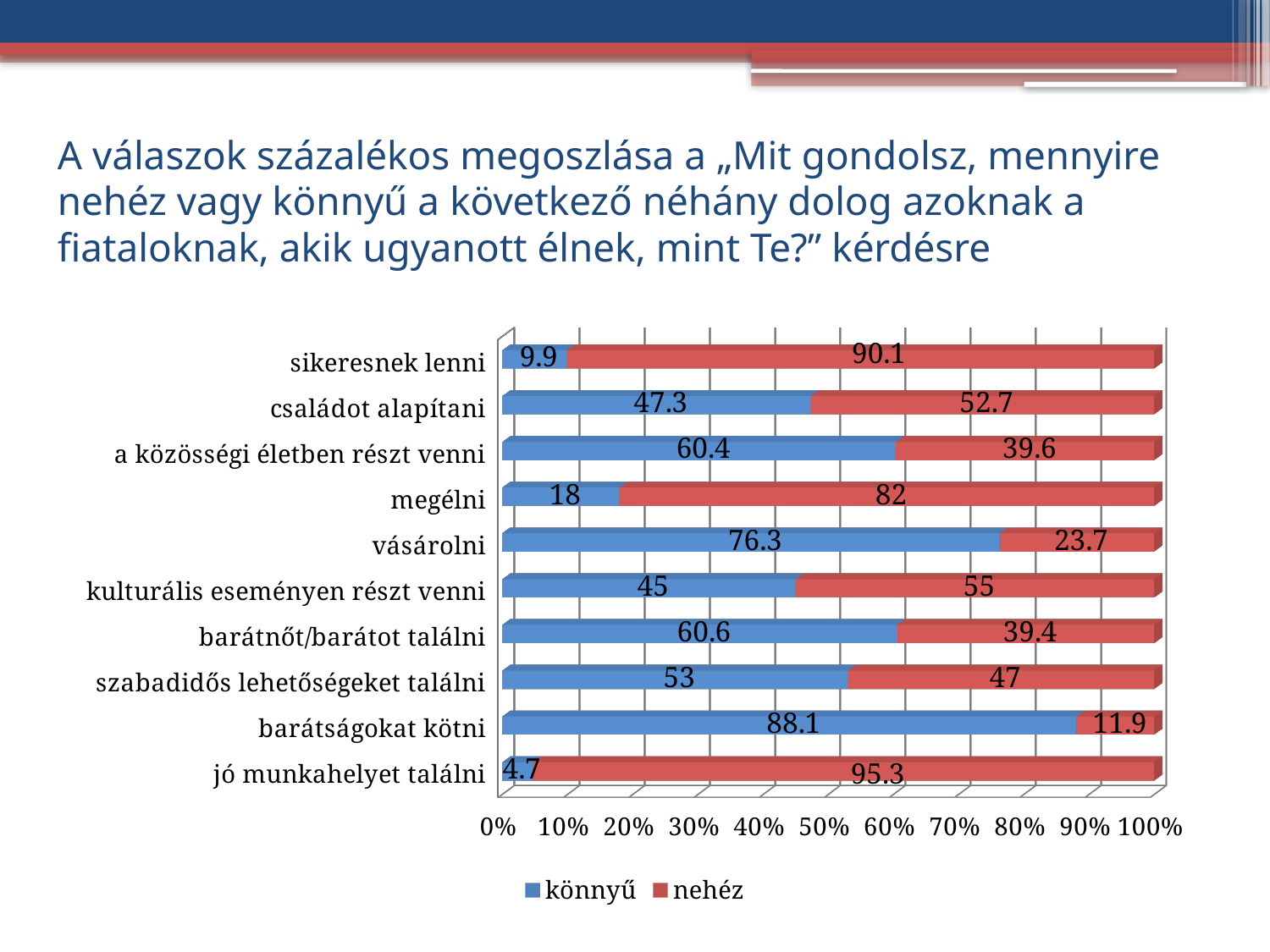
What colour represents the 'nehéz' series? red Which category has the highest 'nehéz' value? jó munkahelyet találni What is the 'nehéz' value for 'sikeresnek lenni'? 90.1 What is the 'könnyű' value for 'jó munkahelyet találni'? 4.7 What is the difference between the 'nehéz' and 'könnyű' values for 'megélni'? 64 Which category has the lowest 'könnyű' value? jó munkahelyet találni What is the 'könnyű' value for 'vásárolni'? 76.3 How many categories are shown on the chart? 10 Which is larger for 'családot alapítani': the 'könnyű' value or the 'nehéz' value? nehéz What kind of chart is shown on the slide? stacked bar chart How many series does the legend list? 2 Which category has the highest 'könnyű' value? barátságokat kötni